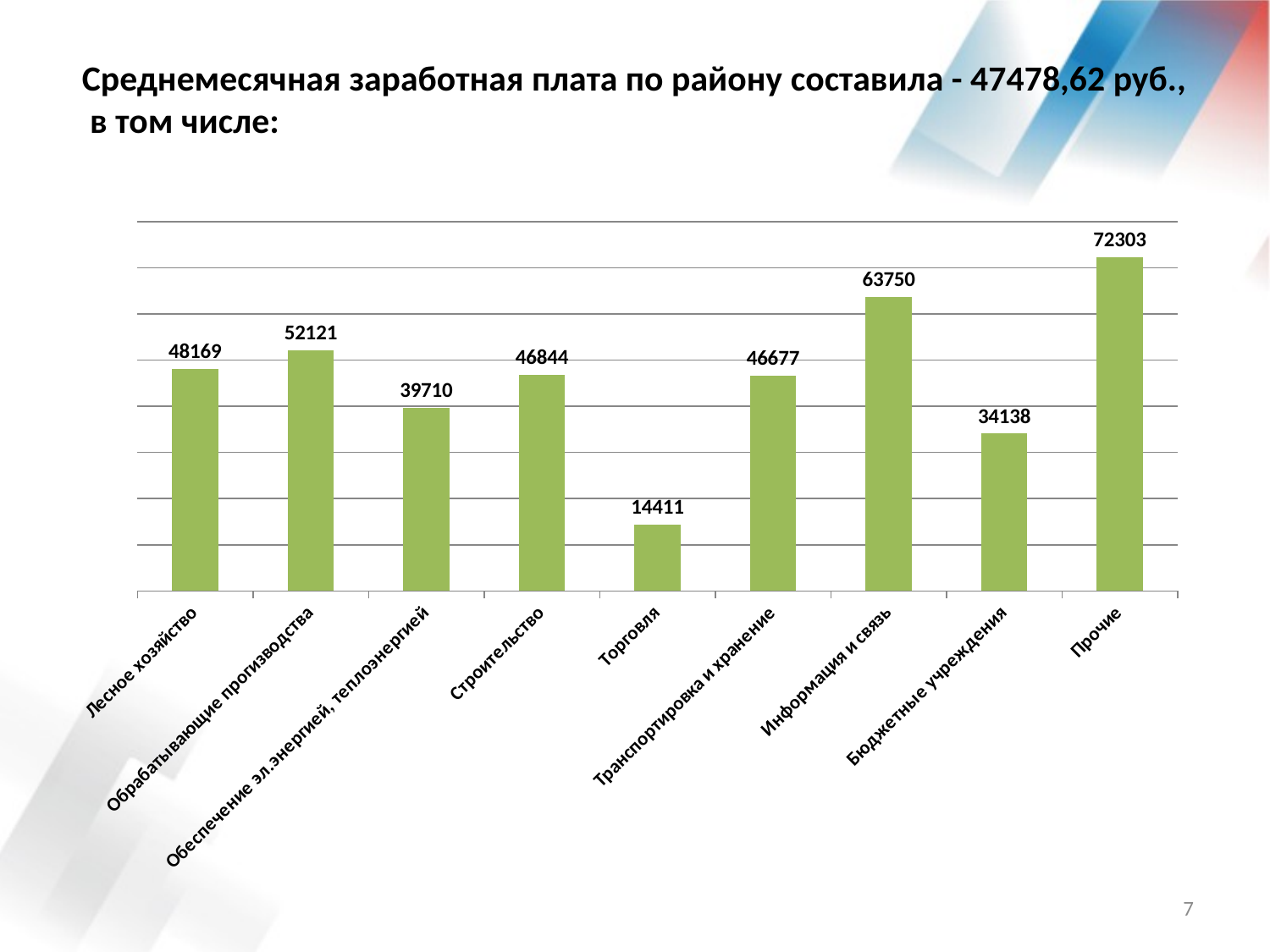
Which category has the lowest value? Торговля What kind of chart is shown on the slide? Bar chart How many categories are shown in the chart? 9 Which is larger, the value for Лесное хозяйство or the value for Бюджетные учреждения? Лесное хозяйство What colour are the bars in the chart? Green What is the value for Информация и связь? 63750 What is the difference between the values for Информация и связь and Обрабатывающие производства? 11629 Which category has the highest value? Прочие What is the value for Обрабатывающие производства? 52121 What is the value for Бюджетные учреждения? 34138 What is the difference between the values for Прочие and Торговля? 57892 What is the value for Торговля? 14411